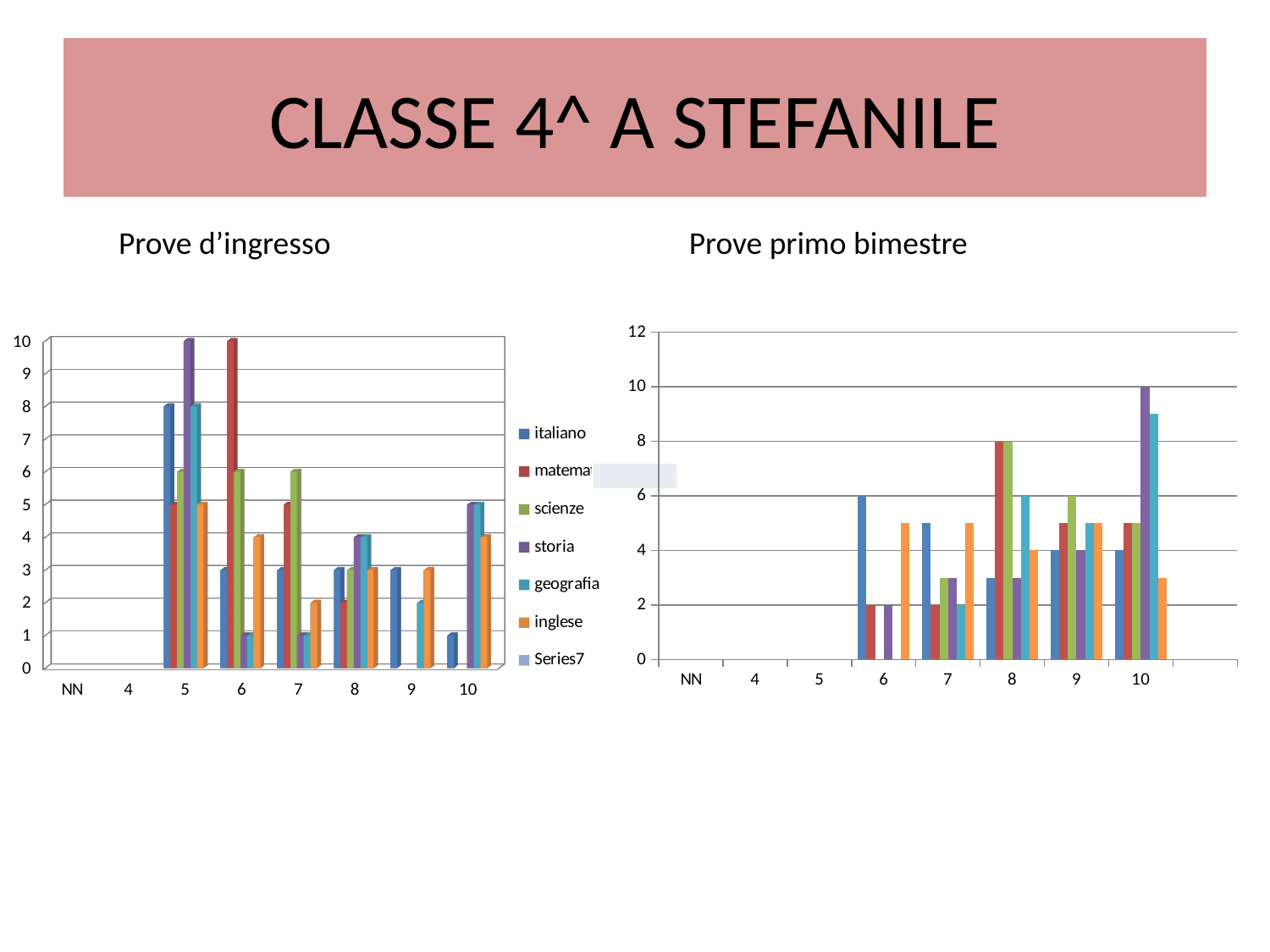
In the Prove primo bimestre chart, is the value of the blue bar at category 7 greater or less than 4? greater In the Prove primo bimestre chart, what is the value of the purple bar at category 10? 10 In the Prove d'ingresso chart, which is larger at category 8: the value for storia or the value for matematica? storia In the Prove d'ingresso chart, what is the value for italiano at category 5? 8 In the Prove d'ingresso chart, which category has the highest value for matematica? 6 In the Prove primo bimestre chart, what is the value of the red bar at category 8? 8 In the Prove primo bimestre chart, is the value of the teal bar at category 10 greater or less than 8? greater How many categories are shown on the x axis of the Prove d'ingresso chart? 8 How many series does the legend of the Prove d'ingresso chart list? 7 In the Prove d'ingresso chart, what is the value for storia at category 5? 10 What kind of chart is the Prove primo bimestre chart? bar chart In the Prove d'ingresso chart, what is the difference between the italiano value at category 5 and the italiano value at category 6? 5